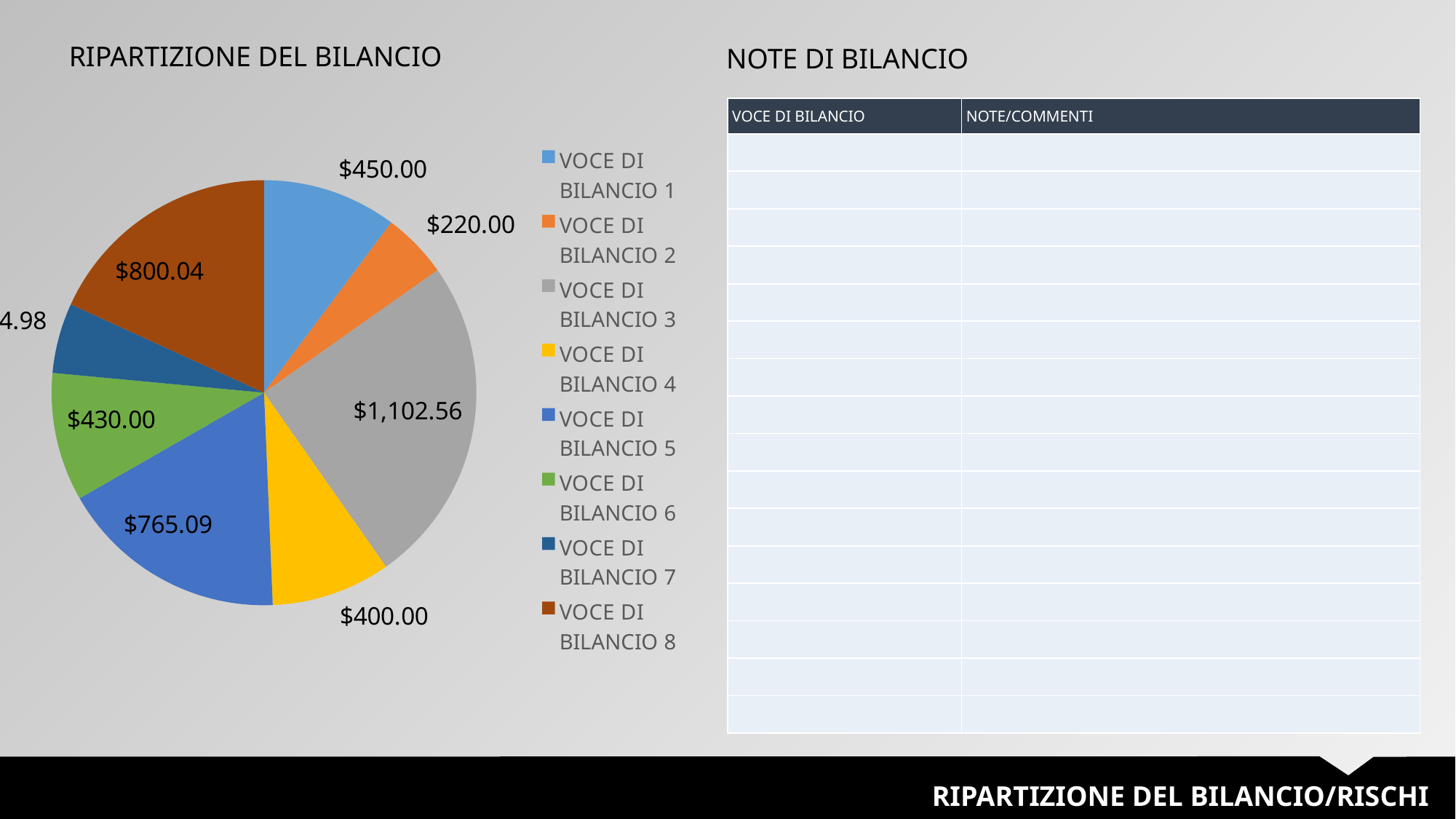
Which is larger in the pie chart: VOCE DI BILANCIO 8 or VOCE DI BILANCIO 5? VOCE DI BILANCIO 8 What is the difference between the values of VOCE DI BILANCIO 1 and VOCE DI BILANCIO 2 in the pie chart? $230.00 What is the value of the slice for VOCE DI BILANCIO 5 in the pie chart? $765.09 What is the value of the slice for VOCE DI BILANCIO 2 in the pie chart? $220.00 How many budget items does the legend of the pie chart list? 8 What is the value of the slice for VOCE DI BILANCIO 3 in the pie chart? $1,102.56 What is the value of the slice for VOCE DI BILANCIO 8 in the pie chart? $800.04 What is the difference between the values of VOCE DI BILANCIO 3 and VOCE DI BILANCIO 5 in the pie chart? $337.47 What colour is the slice for VOCE DI BILANCIO 4 in the pie chart? Yellow Which budget item has the largest slice in the pie chart? VOCE DI BILANCIO 3 What is the value of the slice for VOCE DI BILANCIO 1 in the pie chart? $450.00 What type of chart is shown under the title "RIPARTIZIONE DEL BILANCIO"? Pie chart